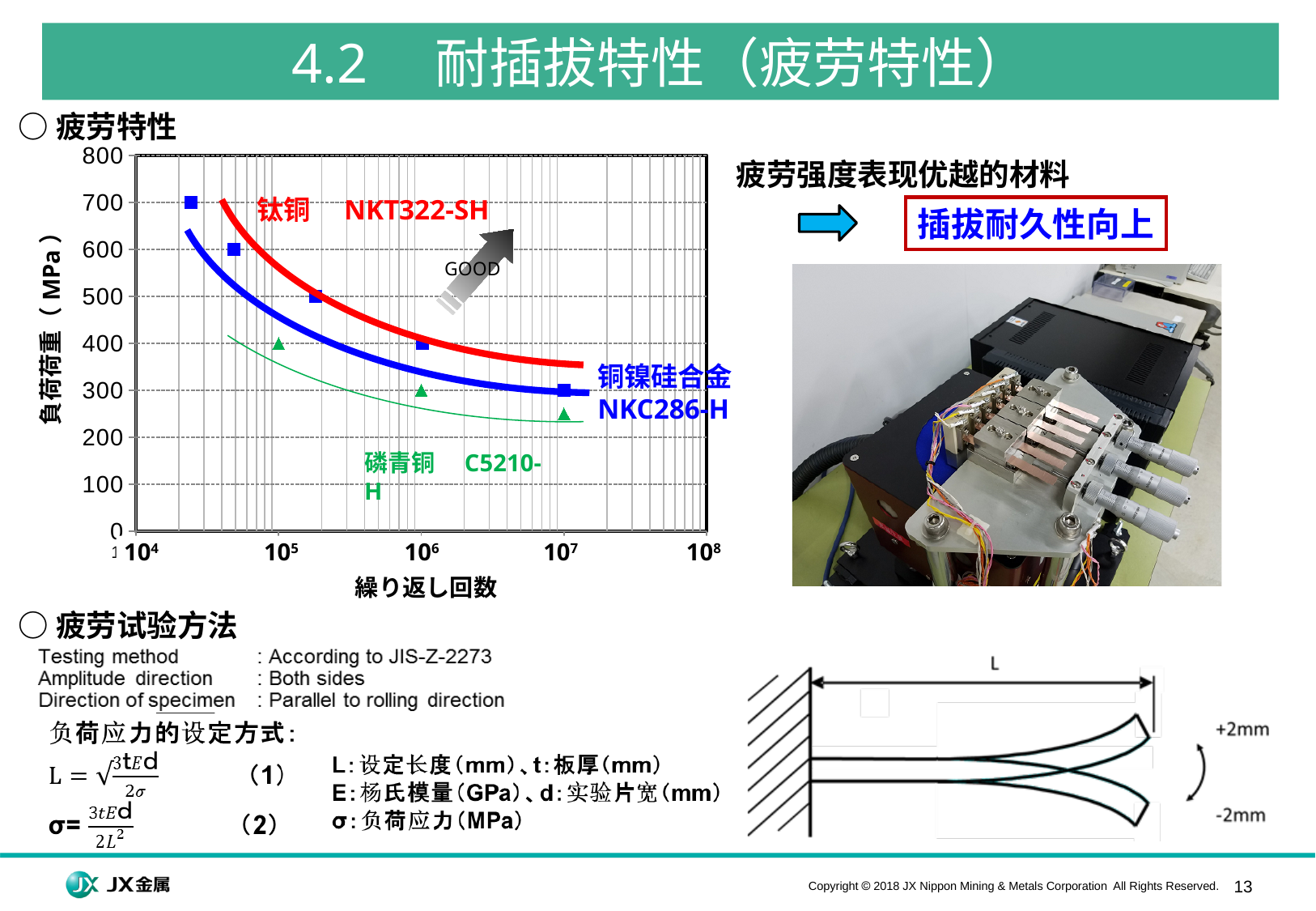
Which material's curve is the lowest on the fatigue chart? 磷青铜 C5210-H What colour is the 钛铜 NKT322-SH curve on the fatigue chart? red What is the y-axis label of the fatigue chart? 負荷荷重（MPa） On the fatigue chart, is the value of the 钛铜 NKT322-SH curve at 10^7 cycles greater or less than 300 MPa? greater Does the load stress rise or fall as the number of cycles increases on the fatigue chart? fall On the fatigue chart, is the value of the 磷青铜 C5210-H curve at 10^7 cycles greater or less than 300 MPa? less On the fatigue chart, which has the higher load stress at 10^6 cycles: 钛铜 NKT322-SH or 磷青铜 C5210-H? 钛铜 NKT322-SH How many materials are plotted on the fatigue chart? 3 On the fatigue chart, which has the higher load stress at 10^7 cycles: 铜镍硅合金 NKC286-H or 磷青铜 C5210-H? 铜镍硅合金 NKC286-H On the fatigue chart, is the value of the 铜镍硅合金 NKC286-H curve at 10^5 cycles greater or less than 400 MPa? greater What kind of chart is shown under 疲劳特性? line chart with scatter points Which material's curve is the highest on the fatigue chart? 钛铜 NKT322-SH